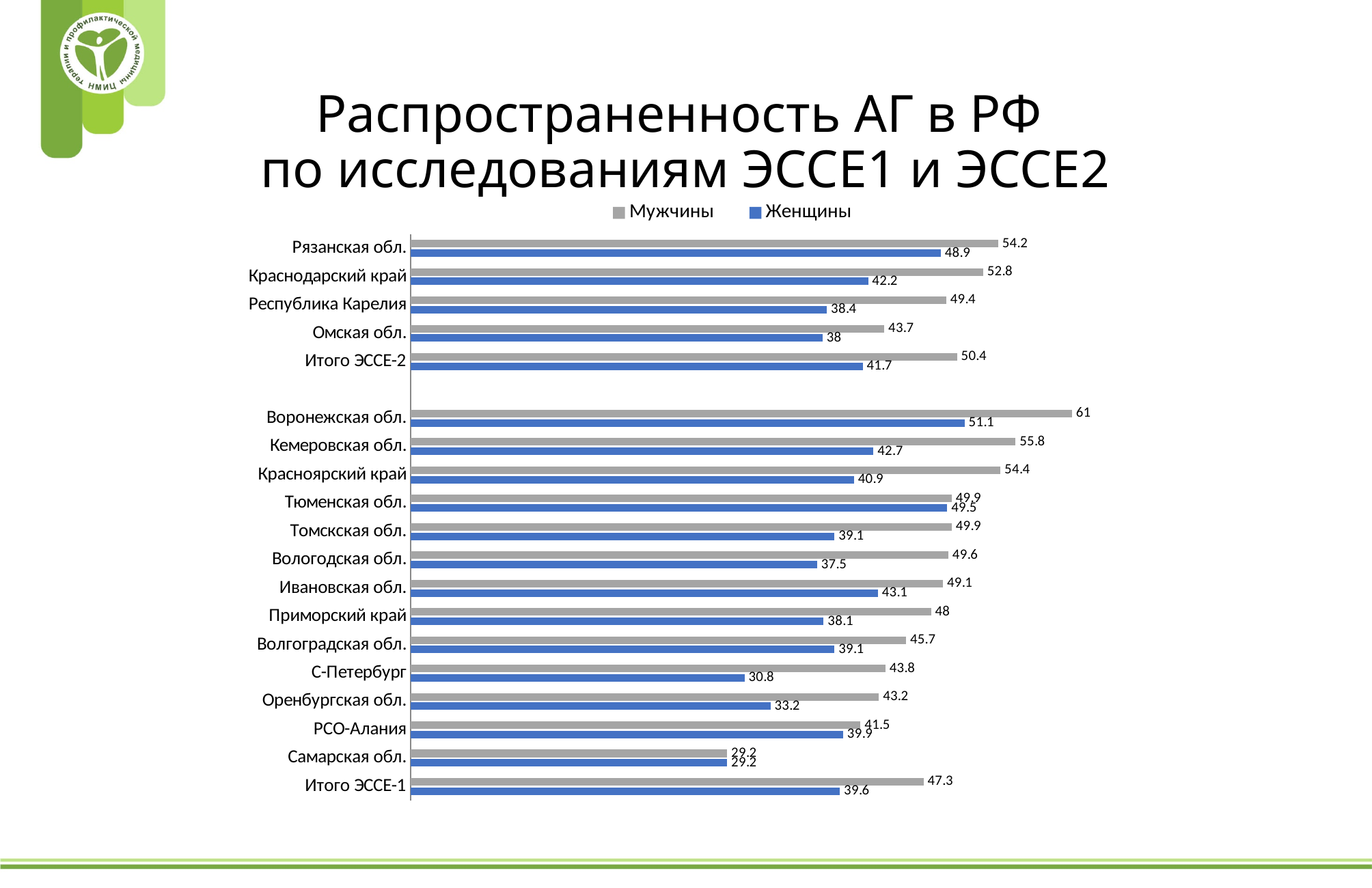
Which is larger: the Женщины value for Рязанская обл. or for Краснодарский край? Рязанская обл. What is the value for Женщины in Итого ЭССЕ-2? 41.7 Which series is shown in grey in the legend? Мужчины Which region has the highest value for Мужчины? Воронежская обл. Which region has the lowest value for Женщины? Самарская обл. What is the value for Мужчины in Итого ЭССЕ-1? 47.3 What is the value for Женщины in С-Петербург? 30.8 What is the difference between the Мужчины values for Итого ЭССЕ-2 and Итого ЭССЕ-1? 3.1 How many series does the legend list? 2 What type of chart is shown on the slide? Bar chart What is the difference between the Мужчины and Женщины values in Воронежская обл.? 9.9 What is the value for Мужчины in Воронежская обл.? 61